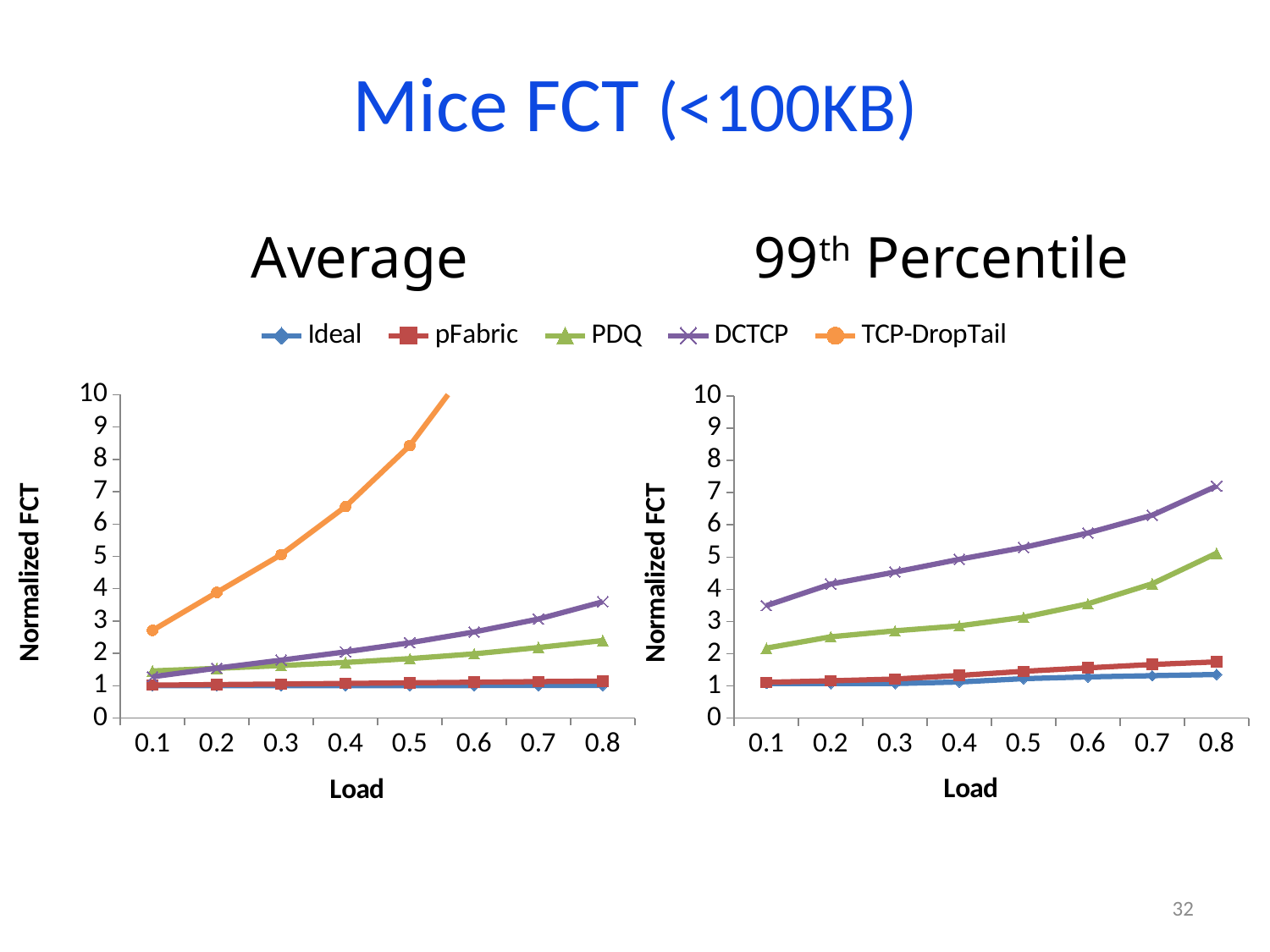
How many load values are shown on the x axis of the 99th Percentile chart? 8 In the 99th Percentile chart, which series has the lowest Normalized FCT at load 0.8? Ideal What is the label of the y axis on both charts? Normalized FCT In the 99th Percentile chart, does the DCTCP series rise or fall as load increases? Rises In the 99th Percentile chart, is the DCTCP value at load 0.8 greater or less than 6? greater How many series does the legend list? 5 What kind of chart is the Average chart on the left? Line chart In the Average chart, is the DCTCP value at load 0.8 greater or less than 4? less In the Average chart, which series has the highest Normalized FCT at load 0.5? TCP-DropTail In the 99th Percentile chart, is the PDQ value at load 0.8 greater or less than 4? greater